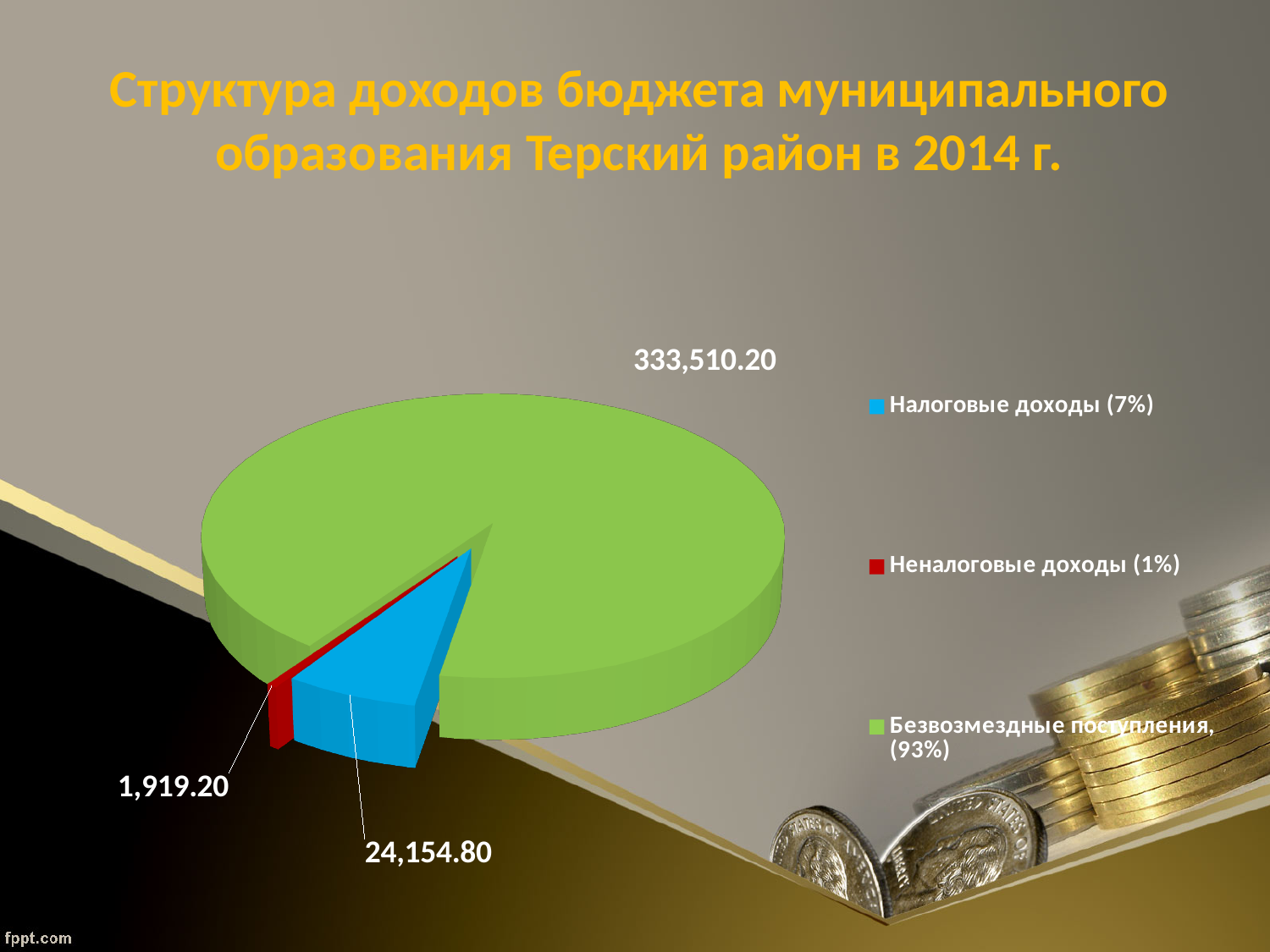
How many categories does the pie chart have? 3 What is the value for Неналоговые доходы? 1,919.20 Which is larger, the value for Налоговые доходы or the value for Неналоговые доходы? Налоговые доходы What share of the pie does Безвозмездные поступления represent? 93% What colour is the slice for Неналоговые доходы? Red Which category has the largest slice of the pie? Безвозмездные поступления What type of chart is shown on the slide? Pie chart What is the value for Налоговые доходы? 24,154.80 Which category has the smallest slice of the pie? Неналоговые доходы What share of the pie does Налоговые доходы represent? 7% What is the difference between the values for Налоговые доходы and Неналоговые доходы? 22,235.60 What is the value for Безвозмездные поступления? 333,510.20